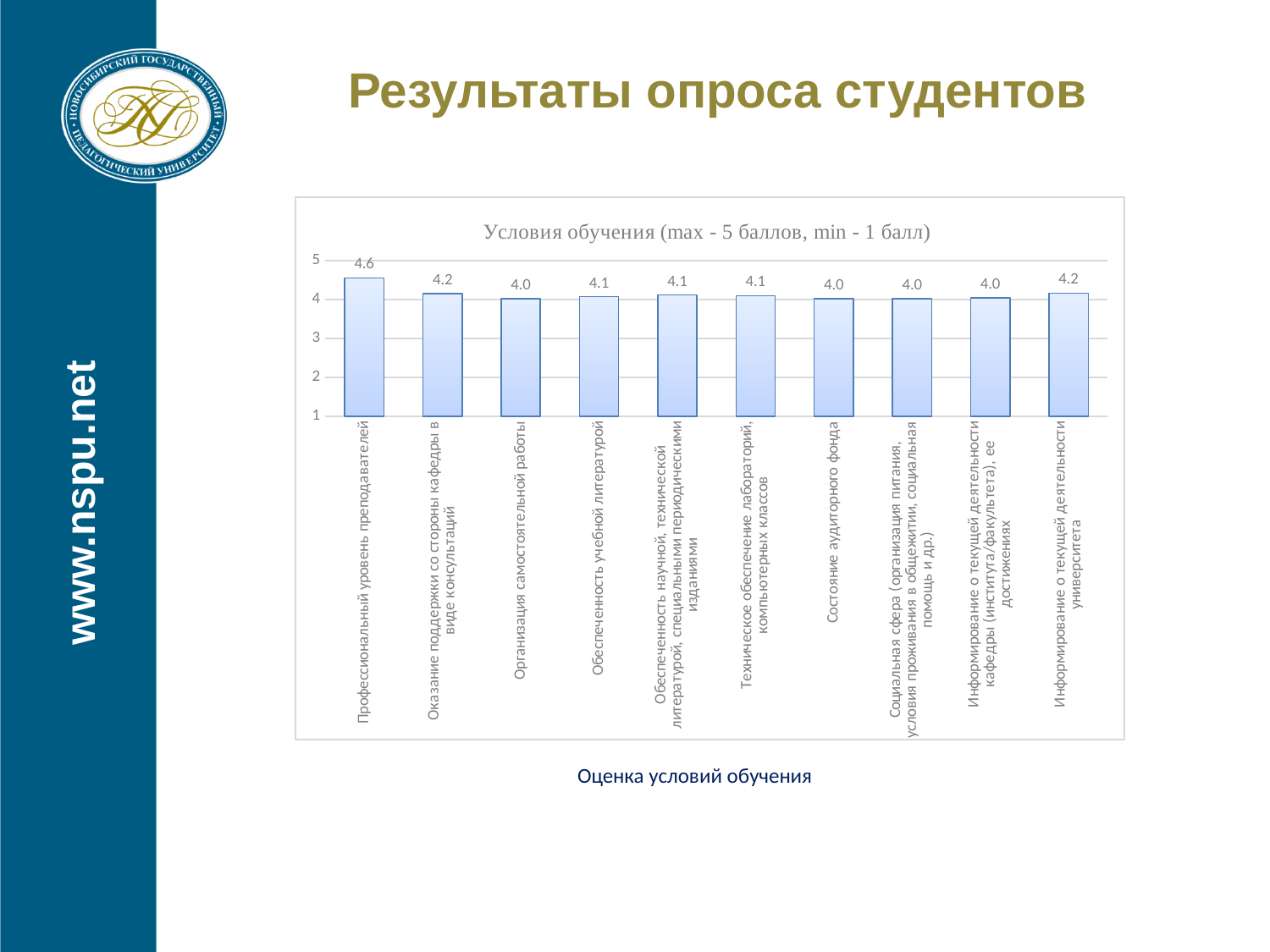
Which category has the highest value? Профессиональный уровень преподавателей What is the value for "Состояние аудиторного фонда"? 4.0 What is the value for "Обеспеченность учебной литературой"? 4.1 What is the value for "Информирование о текущей деятельности университета"? 4.2 Is the value for "Социальная сфера (организация питания, условия проживания в общежитии, социальная помощь и др.)" greater or less than 3? greater What is the difference between the values for "Профессиональный уровень преподавателей" and "Оказание поддержки со стороны кафедры в виде консультаций"? 0.4 What is the value for "Техническое обеспечение лабораторий, компьютерных классов"? 4.1 What is the value for "Профессиональный уровень преподавателей"? 4.6 How many categories are plotted in the chart? 10 What type of chart is shown on the slide? Bar chart Which is larger: the value for "Профессиональный уровень преподавателей" or the value for "Организация самостоятельной работы"? Профессиональный уровень преподавателей What is the title of the chart? Условия обучения (max - 5 баллов, min - 1 балл)